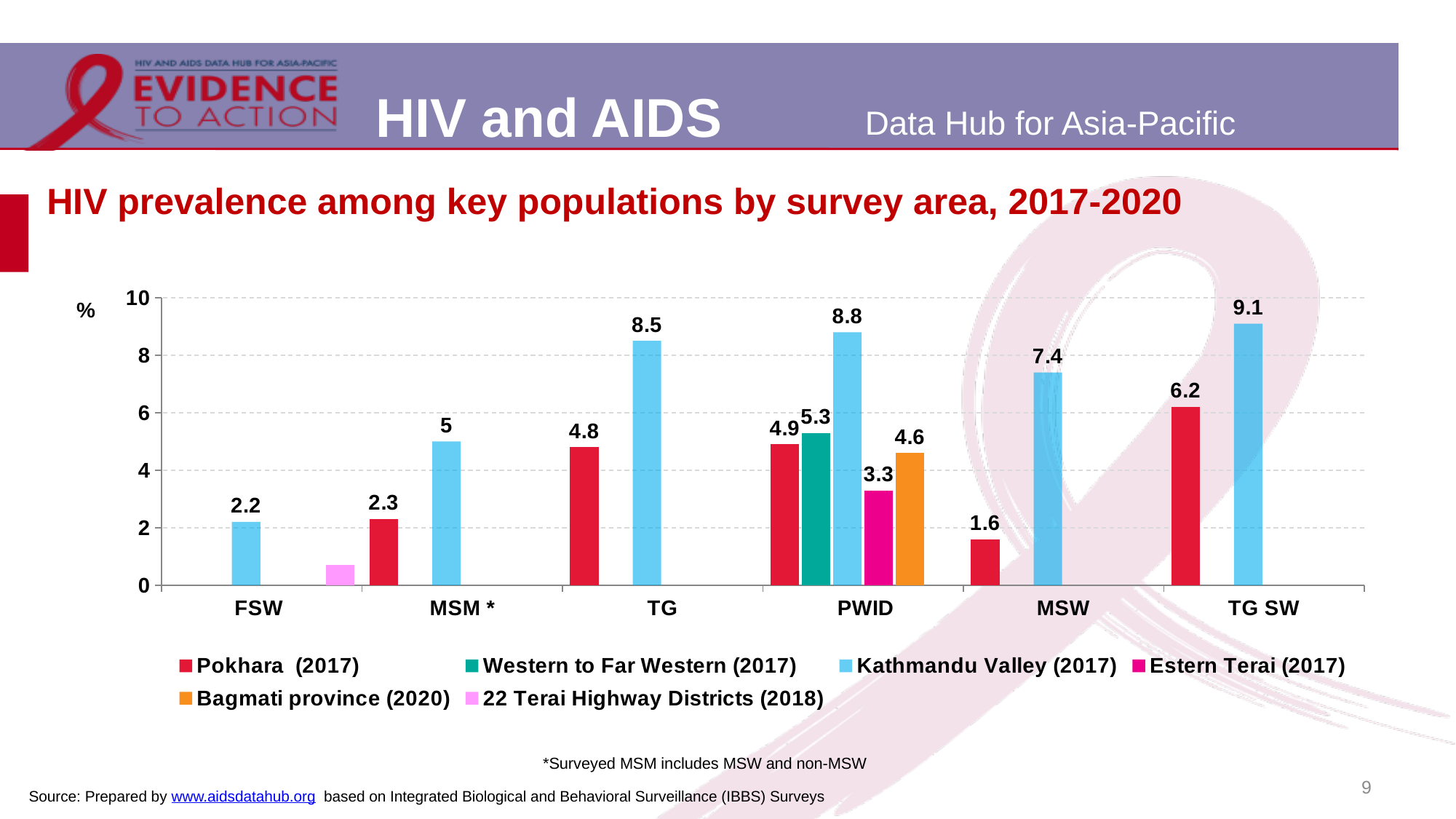
Which key population has the highest Kathmandu Valley (2017) value? TG SW What is the HIV prevalence for Kathmandu Valley (2017) among TG SW? 9.1 What is the value for Bagmati province (2020) among PWID? 4.6 What is the value for Pokhara (2017) in the PWID category? 4.9 Is the value for 22 Terai Highway Districts (2018) among FSW greater or less than 2? less How many survey areas does the legend list? 6 Which key population has the lowest Pokhara (2017) value? MSW Among PWID, which is larger: the Western to Far Western (2017) value or the Estern Terai (2017) value? Western to Far Western (2017) What is the title of the chart? HIV prevalence among key populations by survey area, 2017-2020 How many key population categories are shown on the x axis? 6 In the TG category, what is the difference between the Kathmandu Valley (2017) value and the Pokhara (2017) value? 3.7 What kind of chart is shown on the slide? bar chart